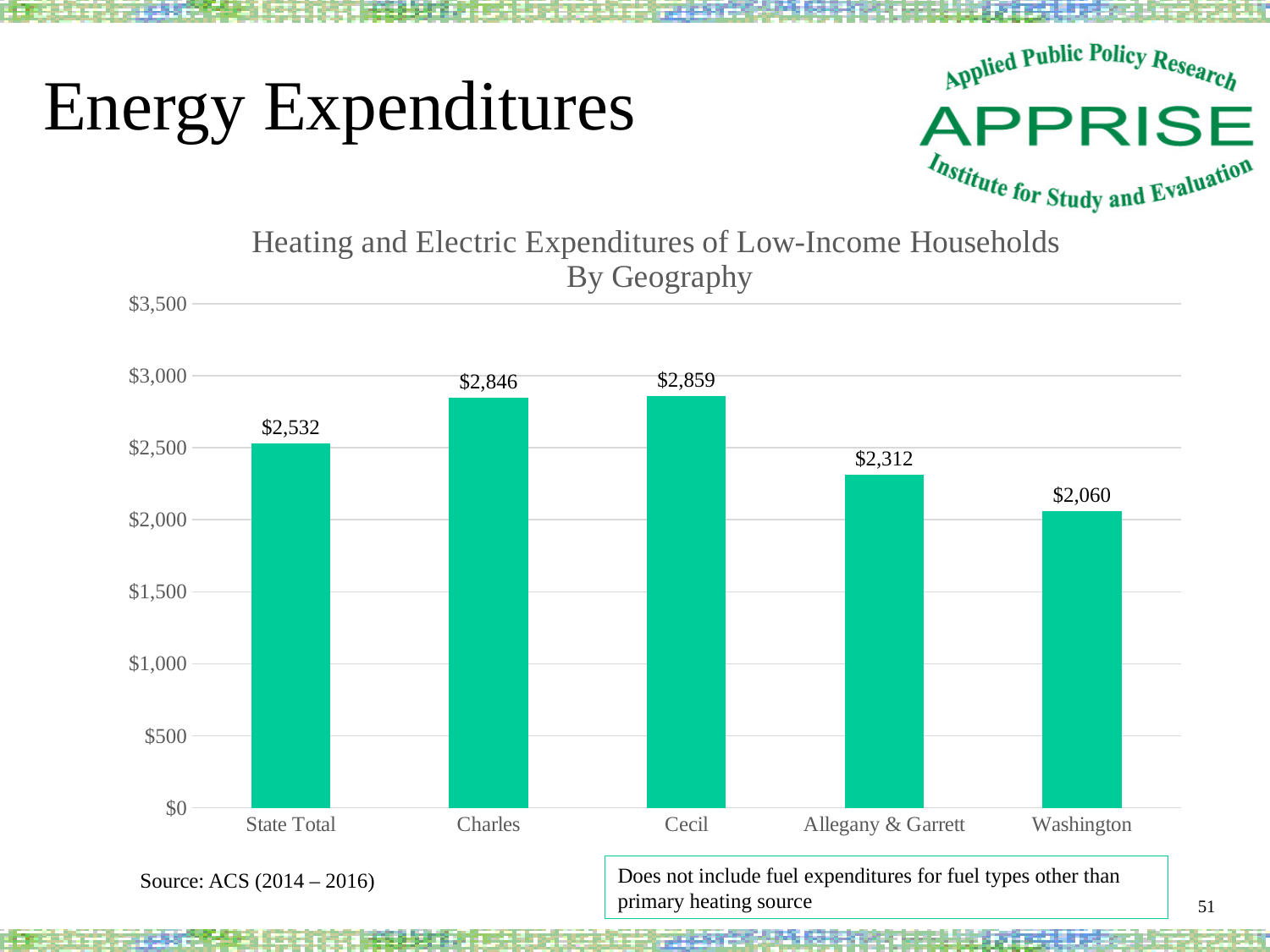
What is the heating and electric expenditure value for Charles? $2,846 How many geographies are shown on the x axis? 5 What is the value shown for Washington? $2,060 What is the title of the chart? Heating and Electric Expenditures of Low-Income Households By Geography Which geography has the highest expenditure? Cecil What kind of chart is shown on the slide? bar chart Which is larger, the value for Charles or the value for Allegany & Garrett? Charles Which geography has the lowest expenditure? Washington What is the difference between the values for State Total and Allegany & Garrett? $220 Is the value for Allegany & Garrett greater or less than $2,500? less What is the difference between the values for Cecil and Washington? $799 What is the value shown for State Total? $2,532